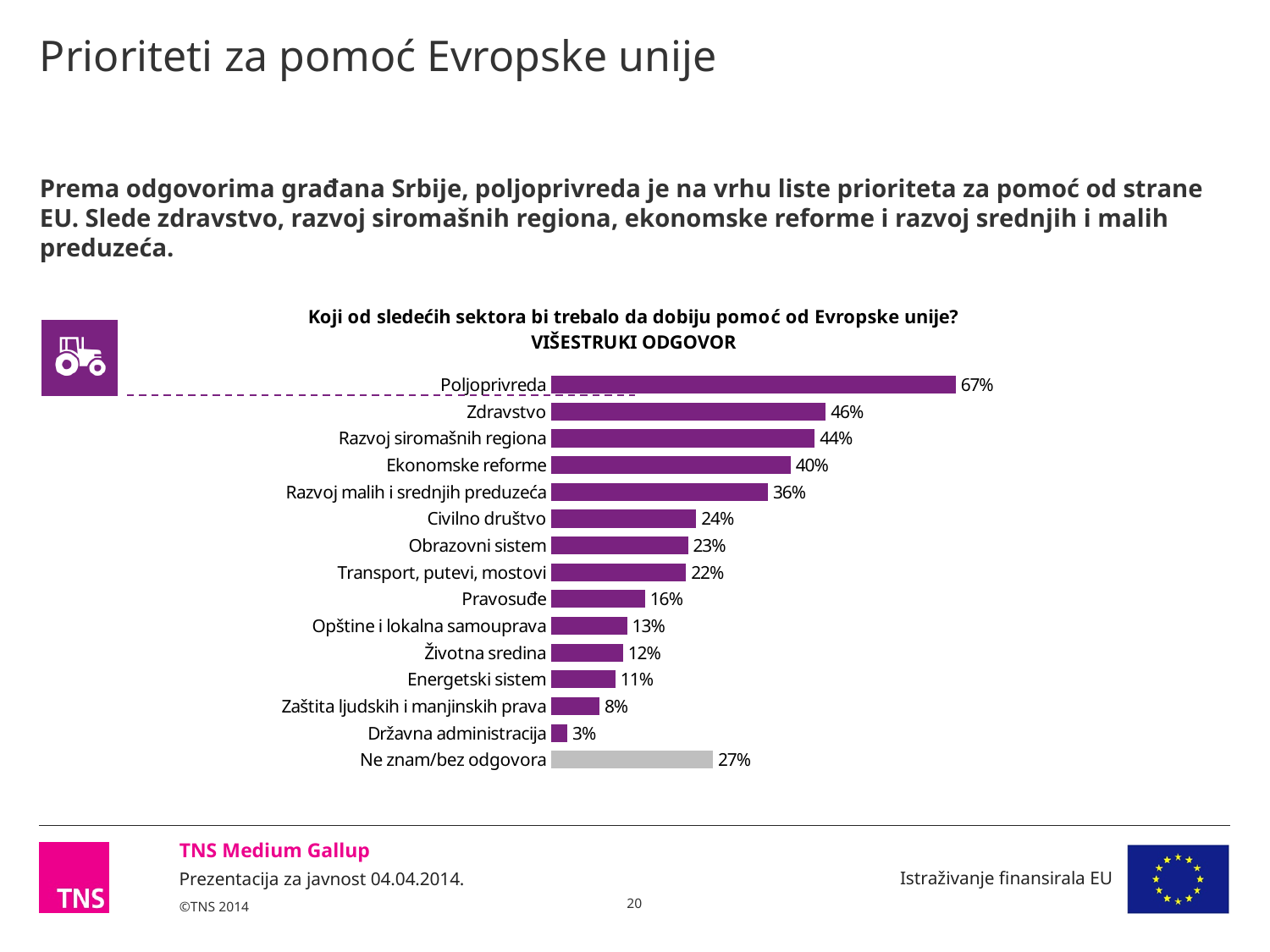
Which is larger, the value for Civilno društvo or the value for Pravosuđe? Civilno društvo What is the value for Ne znam/bez odgovora? 27% Which category has the highest value? Poljoprivreda What is the value for Zdravstvo? 46% What kind of chart is shown on the slide? Bar chart What is the value for Poljoprivreda? 67% What is the value for Energetski sistem? 11% What is the difference between the values for Ekonomske reforme and Razvoj malih i srednjih preduzeća? 4% Which category has the lowest value? Državna administracija What is the difference between the values for Poljoprivreda and Zdravstvo? 21% Which bar is shown in a different colour (grey) from the others? Ne znam/bez odgovora How many categories are shown in the chart? 15